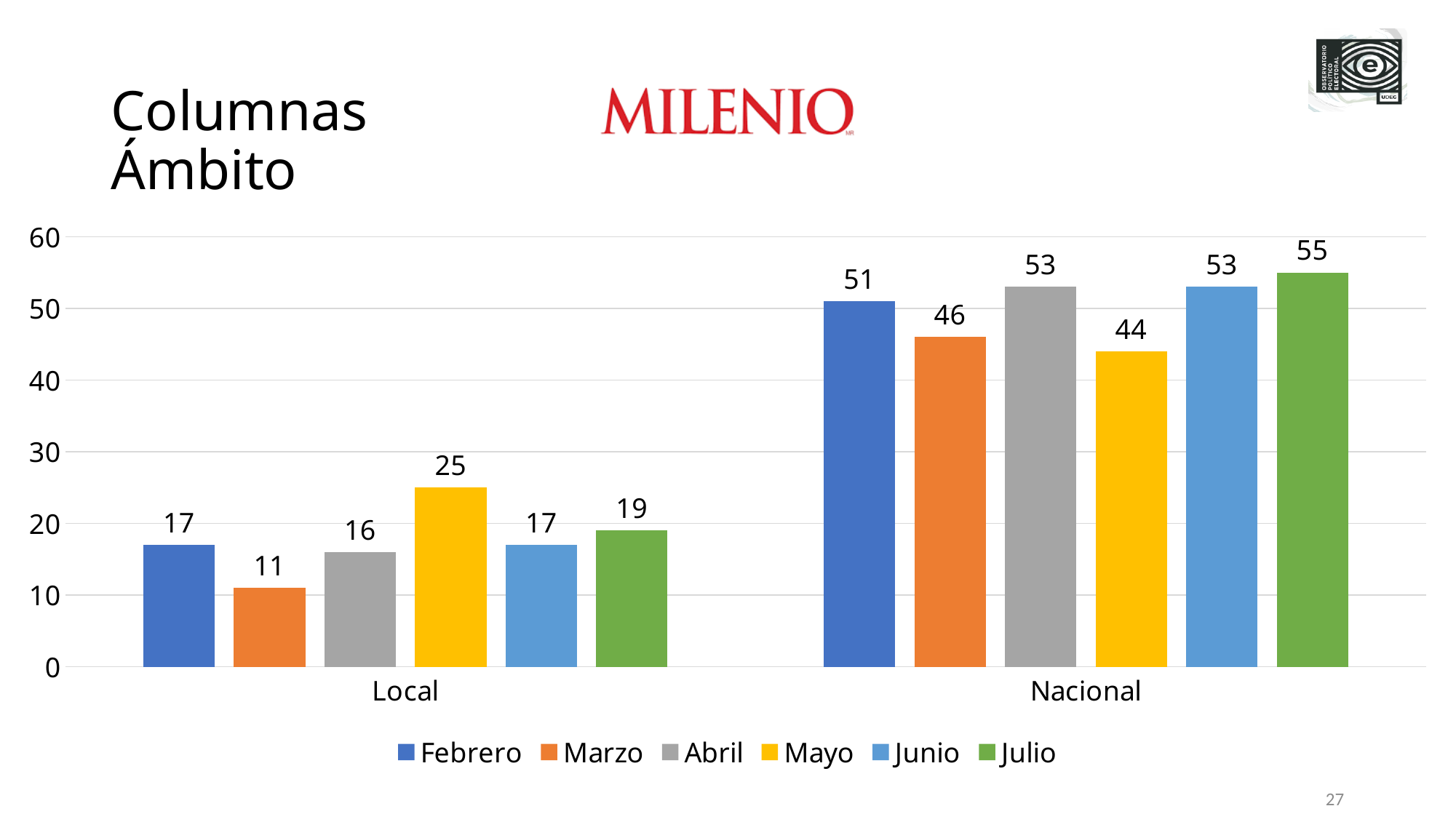
What is the value for Julio in the Nacional category? 55 What is the difference between the Nacional and Local values for Febrero? 34 Which is larger in the Nacional category, Abril or Mayo? Abril How many series does the legend list? 6 What kind of chart is shown on the slide? Bar chart How many categories are shown on the x axis? 2 What is the difference between the Mayo and Marzo values in the Local category? 14 Which colour represents Junio in the legend? Light blue Which month has the lowest value in the Local category? Marzo Which month has the highest value in the Nacional category? Julio What is the value for Mayo in the Local category? 25 What is the value for Marzo in the Nacional category? 46